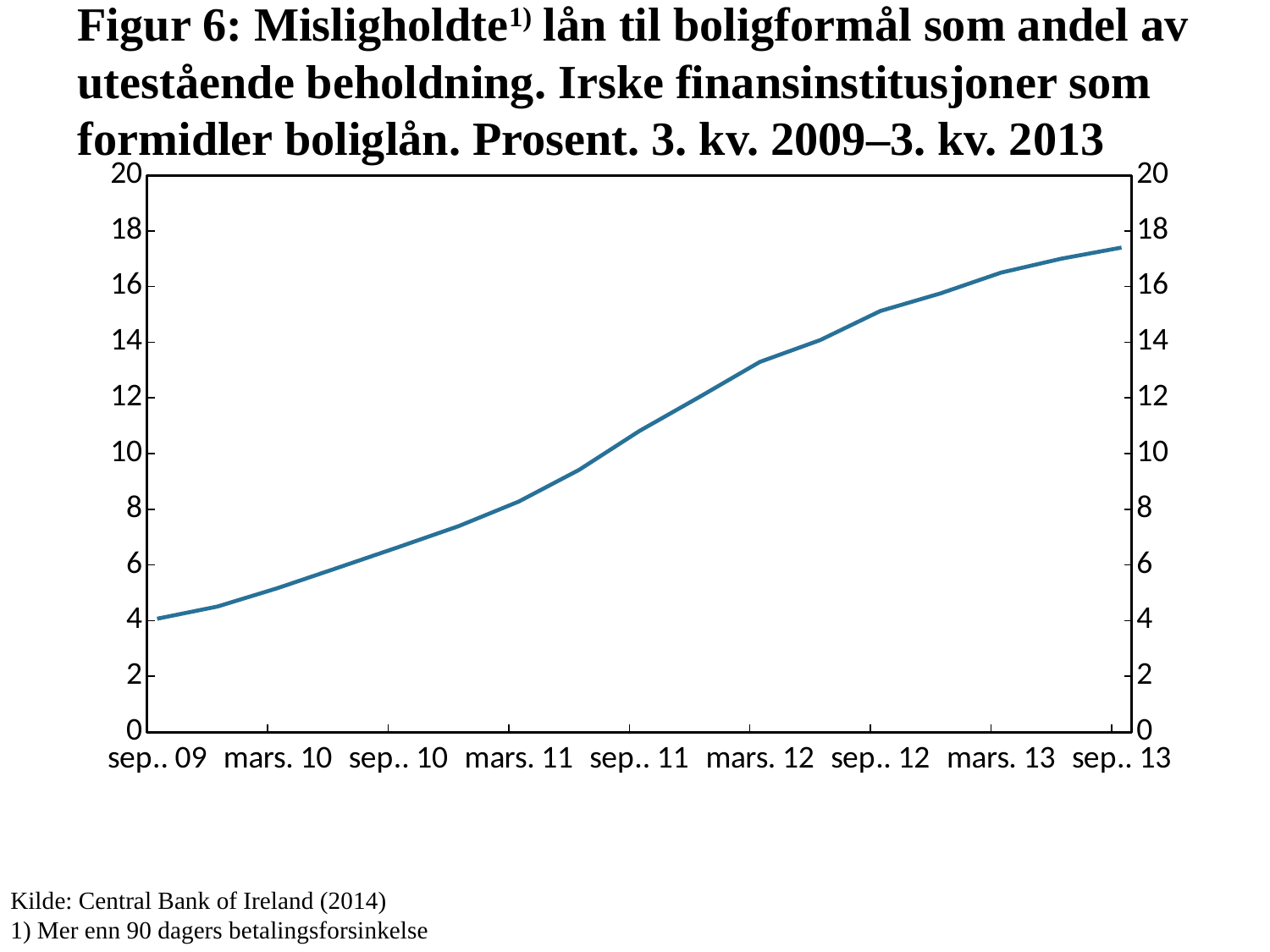
At which x-axis label is the value highest? sep.. 13 Is the value at sep.. 09 greater or less than 6? less At which x-axis label is the value lowest? sep.. 09 Is the value at mars. 11 greater or less than 10? less Is the value at sep.. 13 greater or less than 16? greater Do the values rise or fall from sep.. 09 to sep.. 13? rise How many labels are shown on the x axis? 9 What source is cited for the chart? Central Bank of Ireland (2014) Which is larger, the value at sep.. 11 or the value at mars. 10? sep.. 11 What kind of chart is shown on the slide? line chart